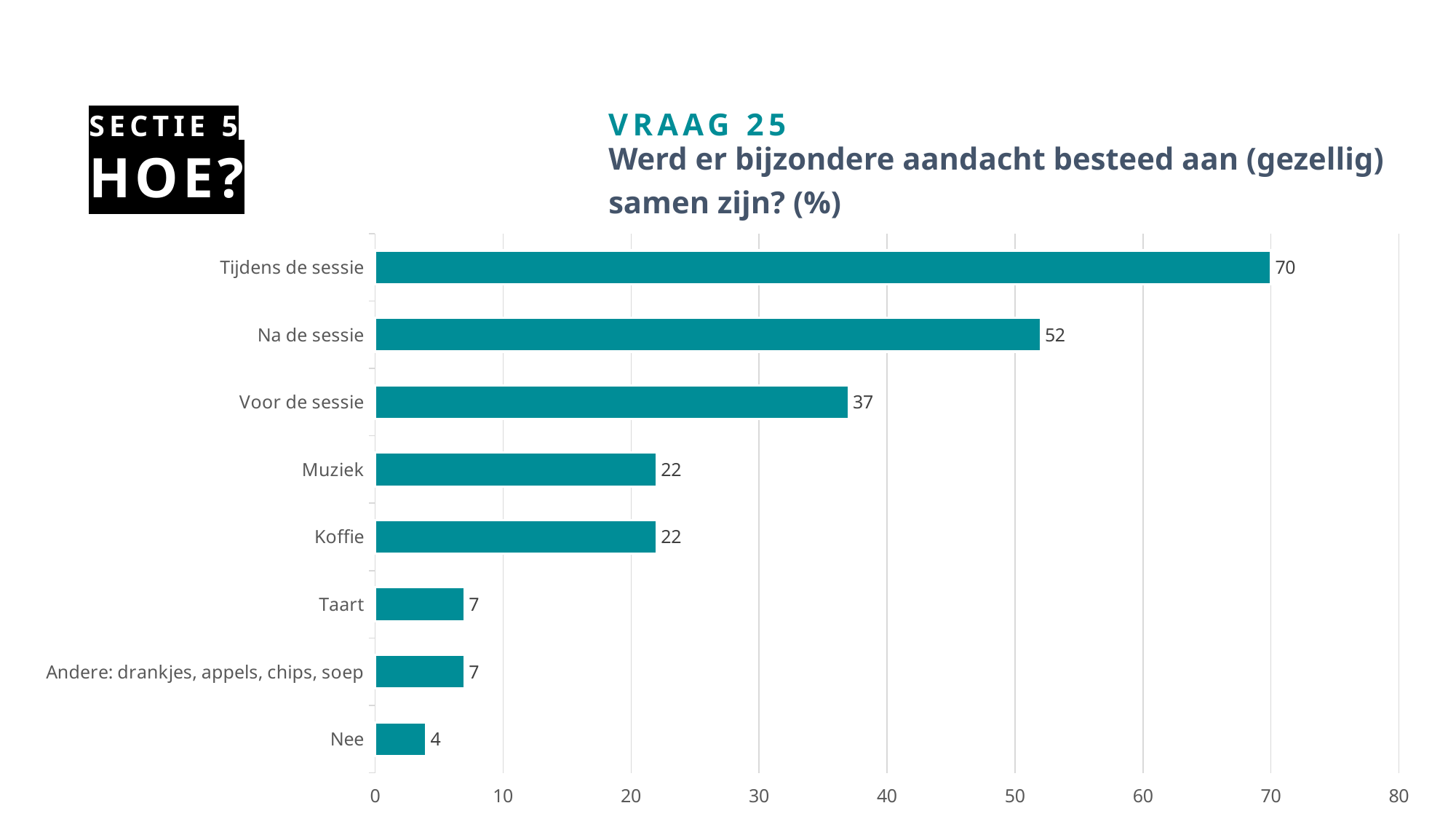
What is the value for 'Voor de sessie'? 37 What is the difference between the values for 'Tijdens de sessie' and 'Na de sessie'? 18 What is the question number shown above the chart title? Vraag 25 Which category has the highest value? Tijdens de sessie How many categories are shown in the chart? 8 What is the value for 'Nee'? 4 What is the value for 'Tijdens de sessie'? 70 What kind of chart is shown on the slide? Bar chart What is the difference between the values for 'Voor de sessie' and 'Muziek'? 15 What is the value for 'Andere: drankjes, appels, chips, soep'? 7 Which category has the lowest value? Nee Which is larger, the value for 'Na de sessie' or the value for 'Voor de sessie'? Na de sessie